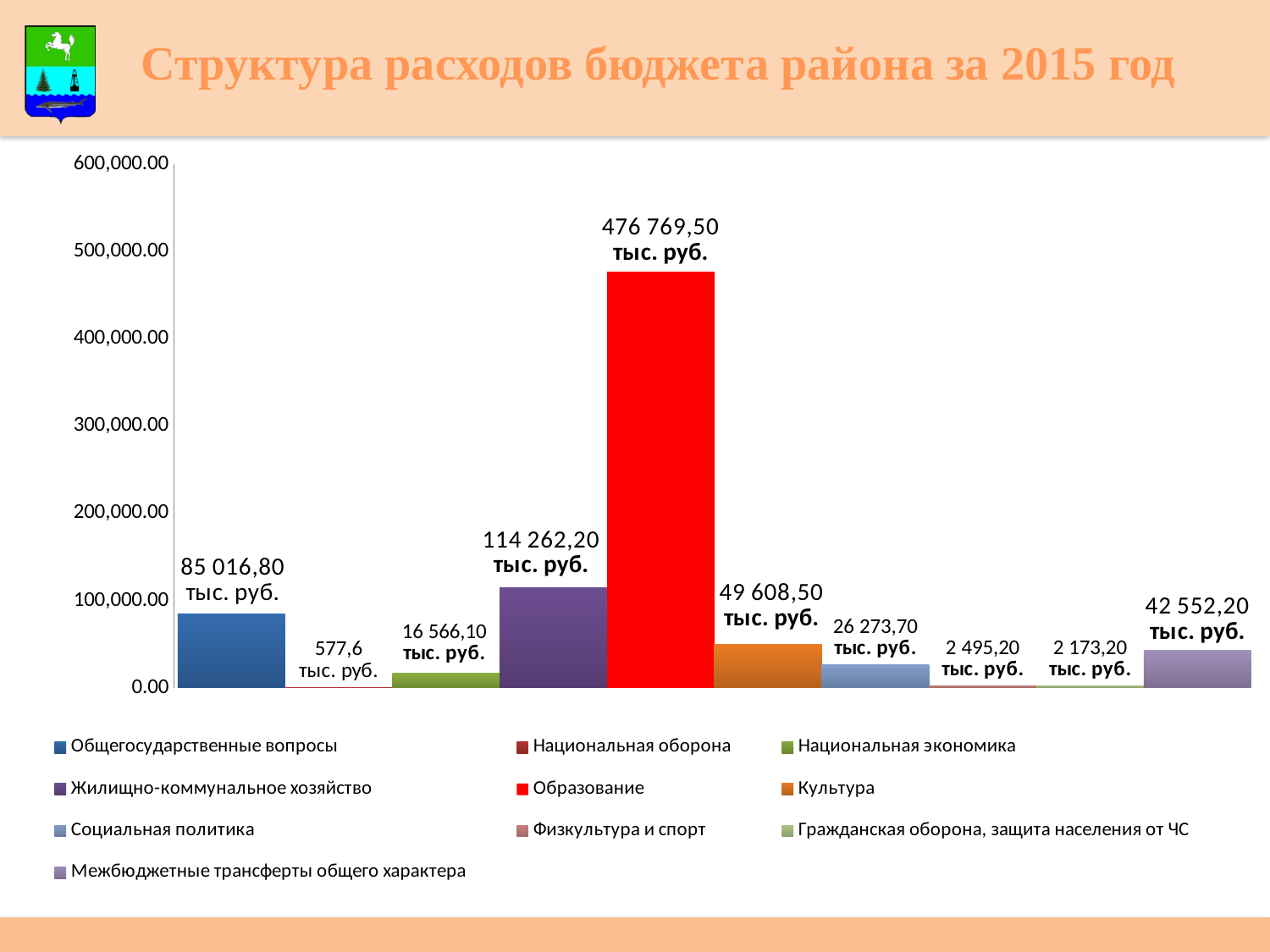
What is the difference between the values for Культура and Межбюджетные трансферты общего характера? 7 056,30 тыс. руб. What is the value for Образование? 476 769,50 тыс. руб. What kind of chart is shown on the slide? Bar chart What is the difference between the values for Образование and Жилищно-коммунальное хозяйство? 362 507,30 тыс. руб. Which expenditure category has the highest value? Образование Which expenditure category has the lowest value? Национальная оборона Is the value for Образование greater or less than 400,000.00? greater What is the value for Жилищно-коммунальное хозяйство? 114 262,20 тыс. руб. What is the value for Межбюджетные трансферты общего характера? 42 552,20 тыс. руб. What is the value for Национальная оборона? 577,6 тыс. руб. How many series does the legend list? 10 Which is larger, the value for Общегосударственные вопросы or the value for Культура? Общегосударственные вопросы